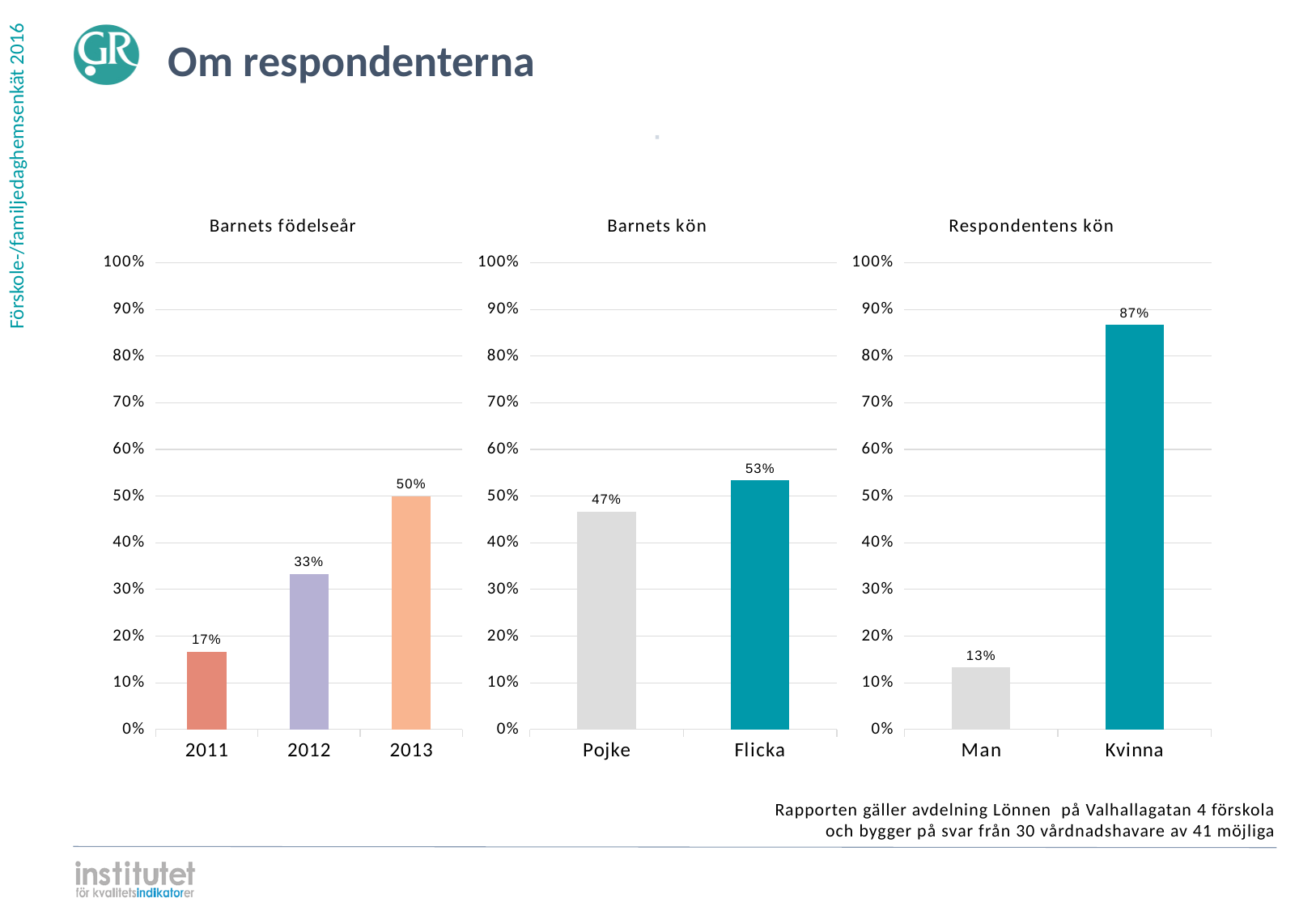
In the 'Barnets födelseår' chart, which birth year has the highest value? 2013 In the 'Barnets kön' chart, what is the difference between Flicka and Pojke? 6% What kind of chart is the 'Respondentens kön' chart? Bar chart In the 'Barnets födelseår' chart, how many categories are shown on the x axis? 3 In the 'Barnets födelseår' chart, what is the value for 2012? 33% In the 'Respondentens kön' chart, what is the value for Kvinna? 87% In the 'Barnets födelseår' chart, which birth year has the lowest value? 2011 In the 'Respondentens kön' chart, what is the value for Man? 13% In the 'Respondentens kön' chart, what is the difference between Kvinna and Man? 74% In the 'Barnets kön' chart, which is larger, Pojke or Flicka? Flicka In the 'Barnets födelseår' chart, what is the difference between the values for 2013 and 2011? 33% In the 'Barnets kön' chart, what is the value for Pojke? 47%